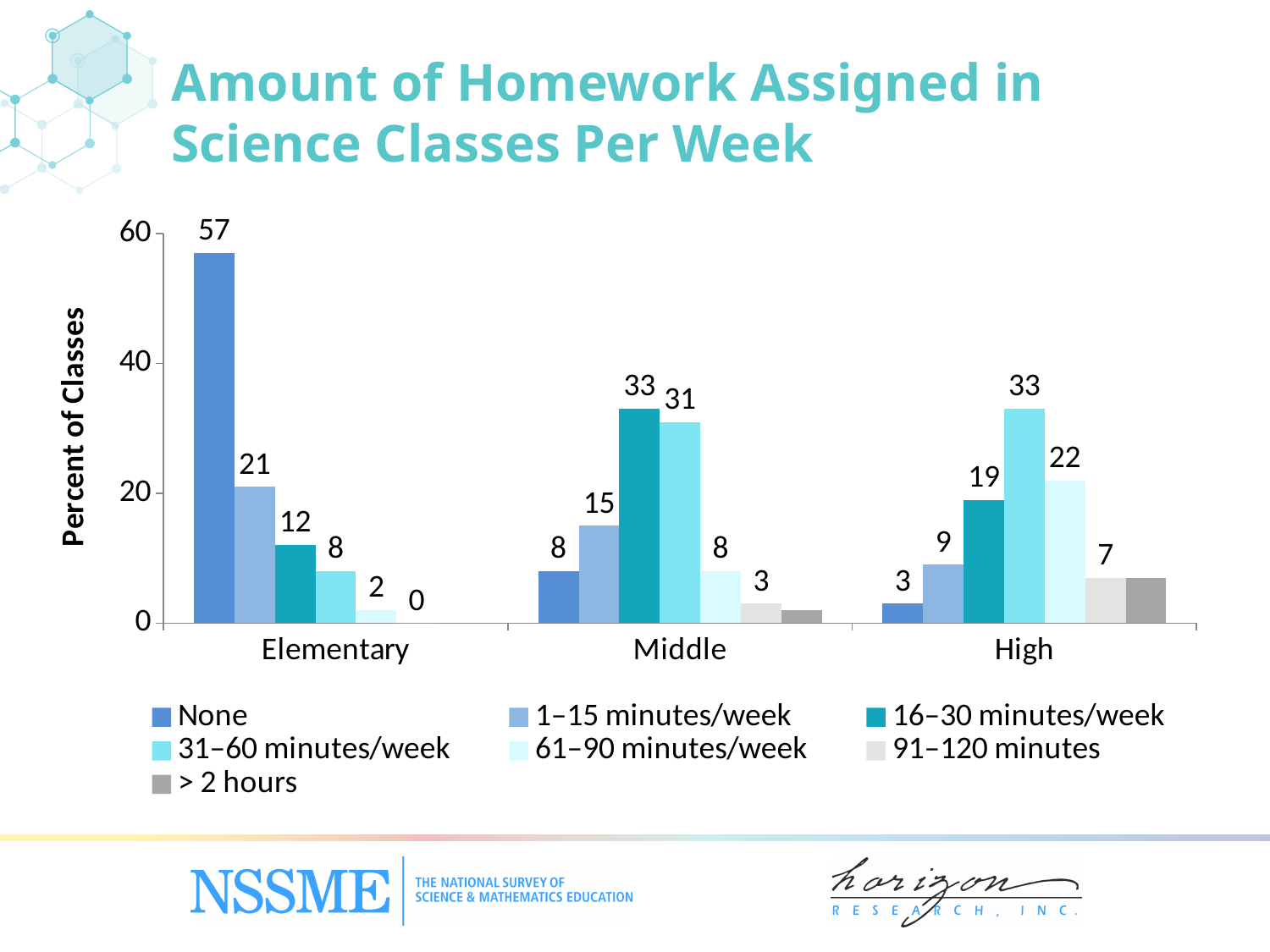
Which homework category has the highest value for High school classes? 31–60 minutes/week What is the value for 61–90 minutes/week in High school classes? 22 What is the value for 91–120 minutes in Middle school classes? 3 How many series does the legend list? 7 What is the value for 16–30 minutes/week in Middle school classes? 33 Is the value for None in Elementary classes greater or less than 40? greater How many grade-level categories are shown on the x axis? 3 What kind of chart is shown on the slide? bar chart Which homework category has the highest value for Elementary classes? None Which is larger: the 1–15 minutes/week value for Middle or for High? Middle What is the difference between the None and 1–15 minutes/week values for Elementary classes? 36 What percent of elementary science classes are assigned no homework (None)? 57